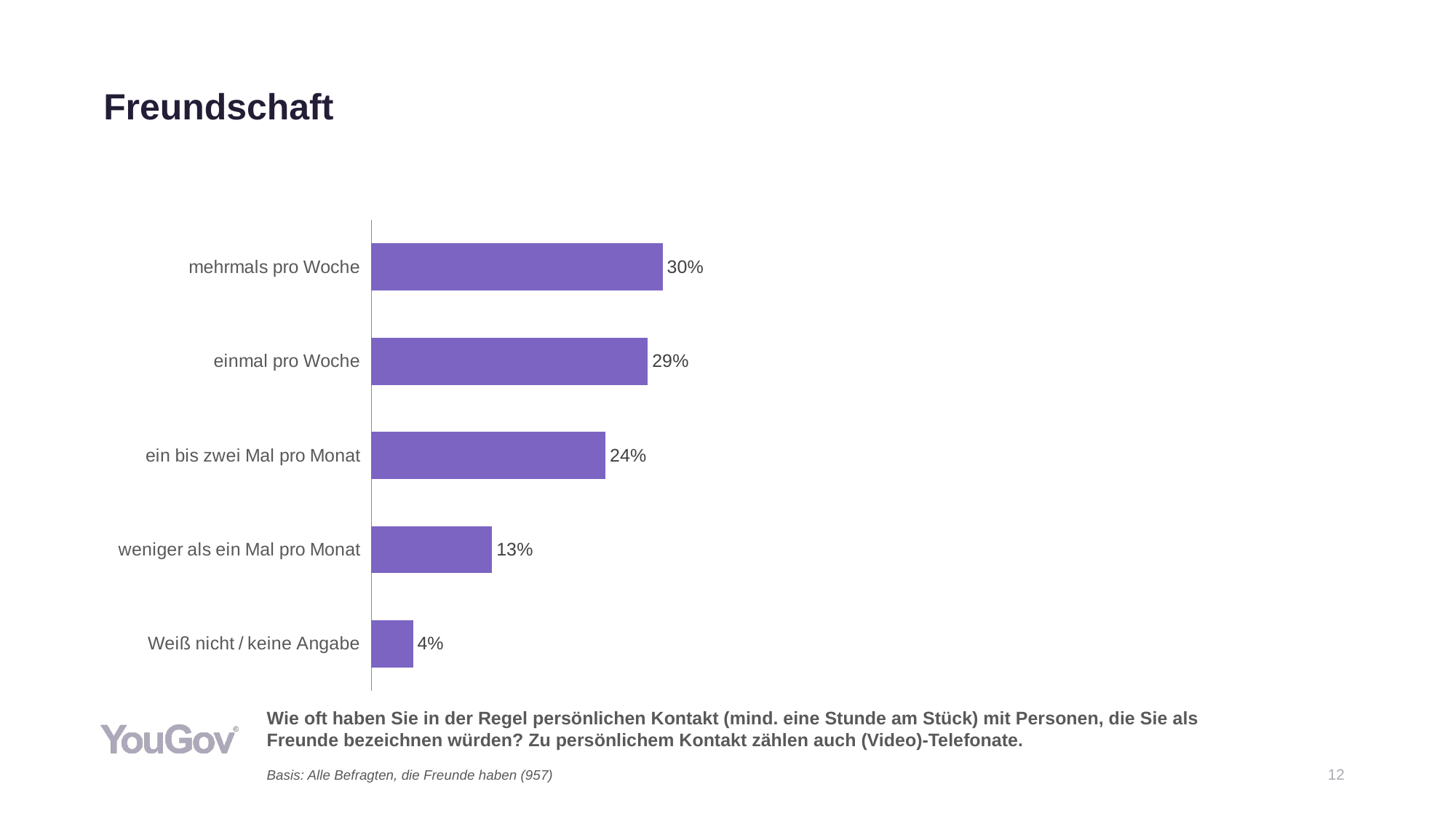
What is the difference between the values for "einmal pro Woche" and "weniger als ein Mal pro Monat"? 16% What is the difference between the values for "mehrmals pro Woche" and "ein bis zwei Mal pro Monat"? 6% What is the value for "ein bis zwei Mal pro Monat"? 24% What is the value for "mehrmals pro Woche"? 30% What is the value for "weniger als ein Mal pro Monat"? 13% Which is larger: the value for "ein bis zwei Mal pro Monat" or the value for "weniger als ein Mal pro Monat"? ein bis zwei Mal pro Monat How many categories are shown in the chart? 5 What is the value for "Weiß nicht / keine Angabe"? 4% What kind of chart is shown on the slide? bar chart Which category has the lowest value? Weiß nicht / keine Angabe What is the base (Basis) stated below the chart? Alle Befragten, die Freunde haben (957) Which category has the highest value? mehrmals pro Woche